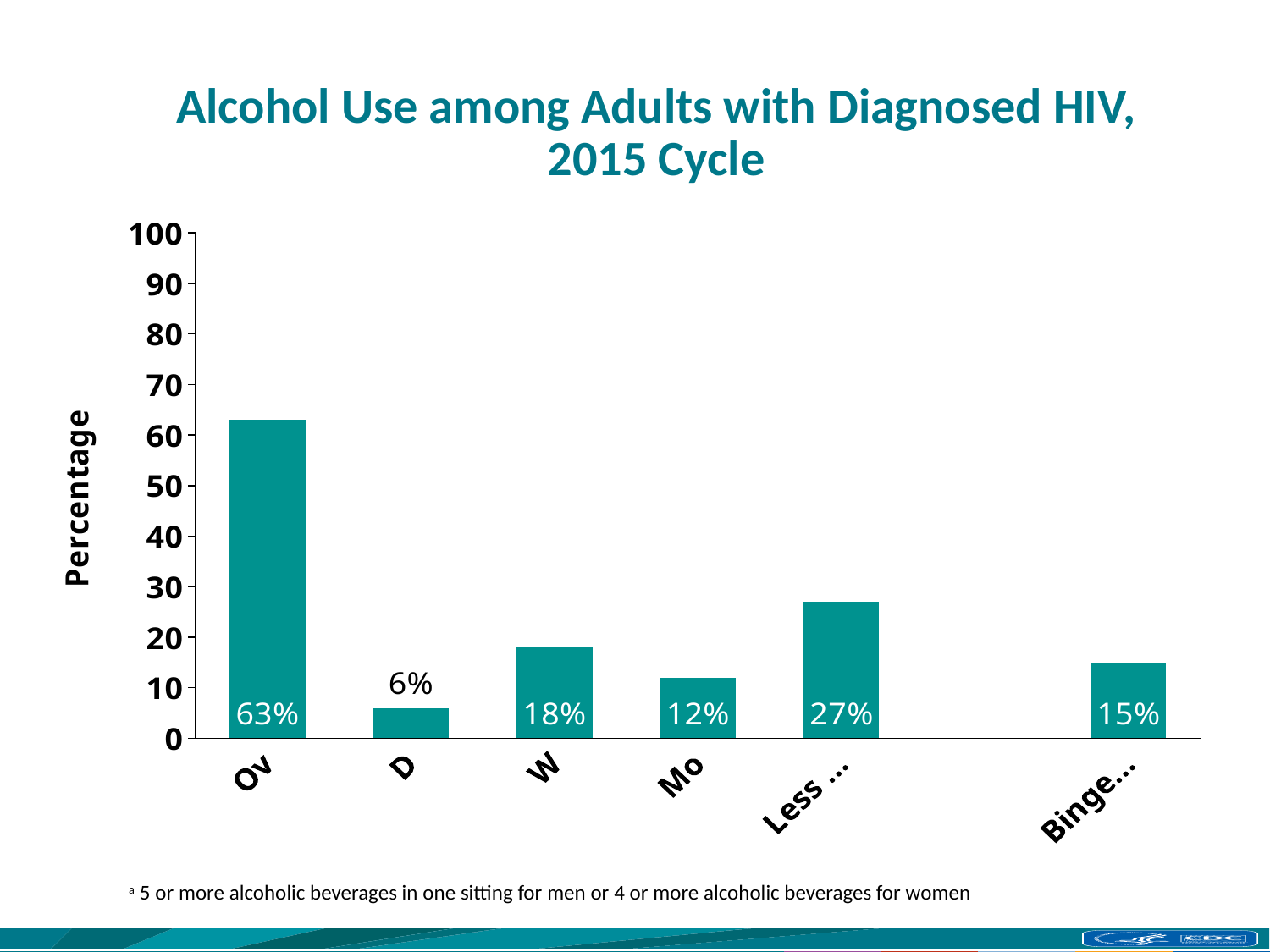
What is the title of the chart? Alcohol Use among Adults with Diagnosed HIV, 2015 Cycle Which is larger, the value of the third bar or the value of the fourth bar? The third bar (18%) Which bar has the highest value, and what is that value? The first (leftmost) bar, 63% What value is shown on the second bar from the left? 6% What is the difference between the value of the first bar (63%) and the fifth bar (27%)? 36 percentage points What value is shown on the first (leftmost) bar of the chart? 63% What is the label on the vertical axis of the chart? Percentage What is the lowest value shown among the bars? 6% What type of chart is shown on the slide? bar chart What value is shown on the fifth bar from the left? 27% How many bars are plotted in the chart? 6 What value is shown on the last (rightmost) bar of the chart? 15%